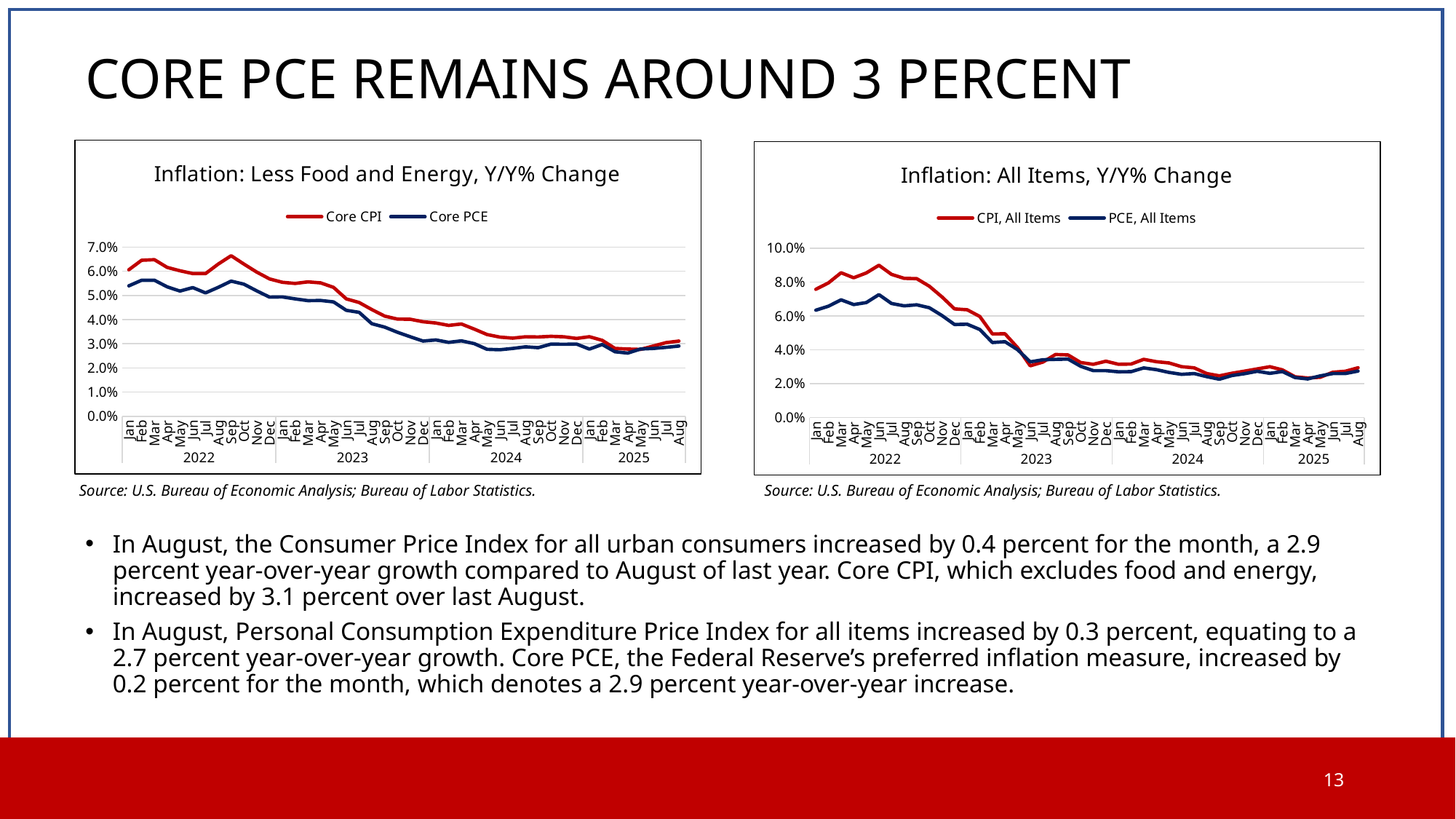
In the 'Inflation: All Items, Y/Y% Change' chart, do the CPI, All Items values generally rise or fall from Jun 2022 to Aug 2025? fall In the 'Inflation: All Items, Y/Y% Change' chart, is the PCE, All Items value for Jun 2022 greater or less than 6.0%? greater How many series does the legend of the 'Inflation: All Items, Y/Y% Change' chart list? 2 In the 'Inflation: All Items, Y/Y% Change' chart, what are the two legend entries? CPI, All Items; PCE, All Items In the 'Inflation: Less Food and Energy, Y/Y% Change' chart, in which month and year does Core CPI reach its highest value? Sep 2022 In the 'Inflation: Less Food and Energy, Y/Y% Change' chart, which series is higher in Jan 2022, Core CPI or Core PCE? Core CPI In the 'Inflation: Less Food and Energy, Y/Y% Change' chart, is the Core CPI value for Sep 2022 greater or less than 6.0%? greater What type of chart is the 'Inflation: Less Food and Energy, Y/Y% Change' chart? line chart In the 'Inflation: All Items, Y/Y% Change' chart, in which month and year does CPI, All Items reach its highest value? Jun 2022 In the 'Inflation: Less Food and Energy, Y/Y% Change' chart, is the Core PCE value for Jun 2024 greater or less than 3.0%? less In the 'Inflation: Less Food and Energy, Y/Y% Change' chart, which series is drawn in red? Core CPI